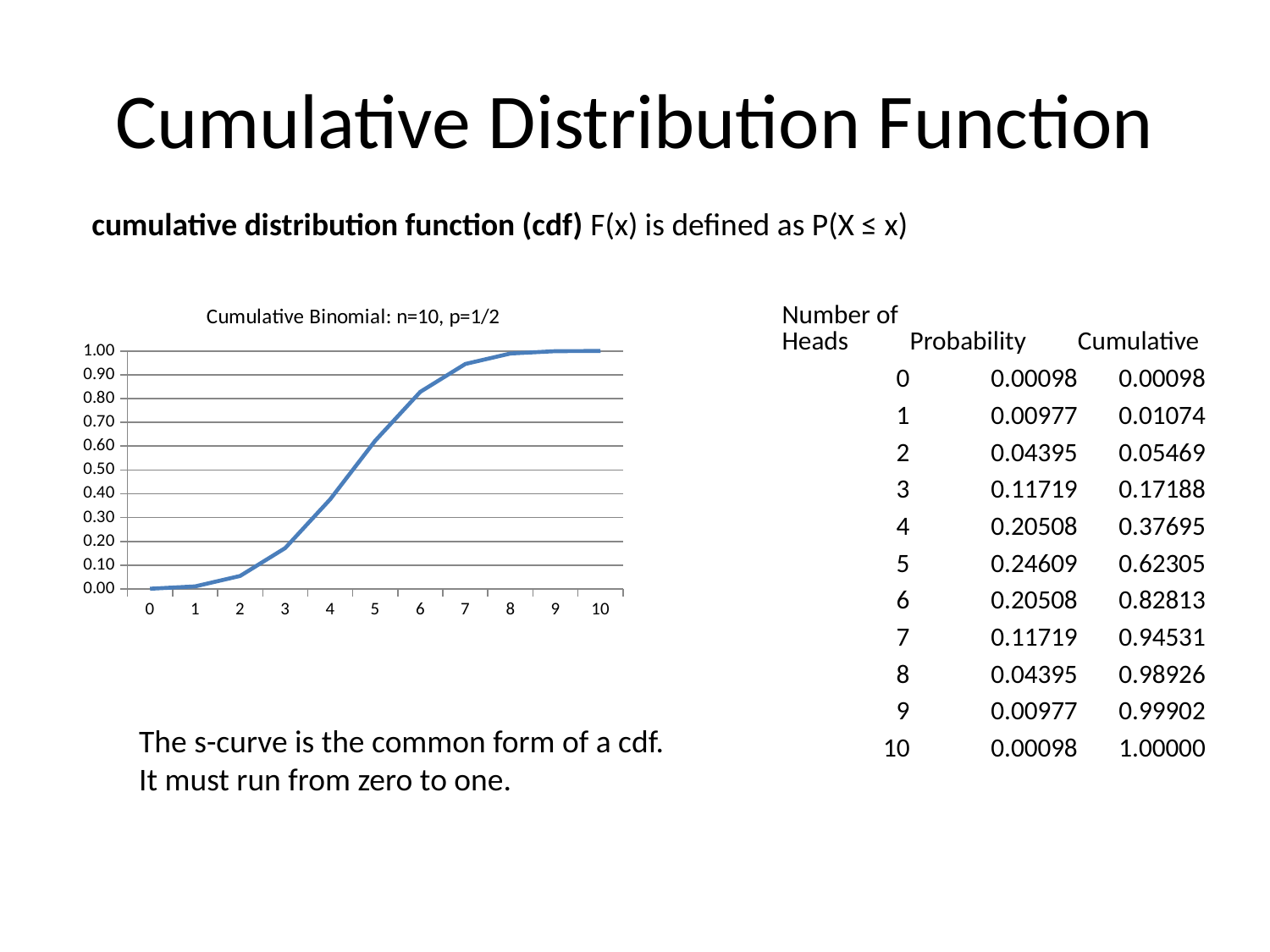
At which x value does the chart reach its highest value? 10 How many points are plotted on the line in the chart? 11 Which is larger, the value plotted at x = 3 or the value plotted at x = 8? x = 8 Do the values in the chart rise or fall as the number of heads increases from 0 to 10? rise Is the value plotted at x = 5 greater or less than 0.50? greater Is the value plotted at x = 7 greater or less than 0.90? greater At which x value is the chart's value lowest? 0 Is the value plotted at x = 2 greater or less than 0.10? less What kind of chart is shown on the slide? line chart What is the title of the chart? Cumulative Binomial: n=10, p=1/2